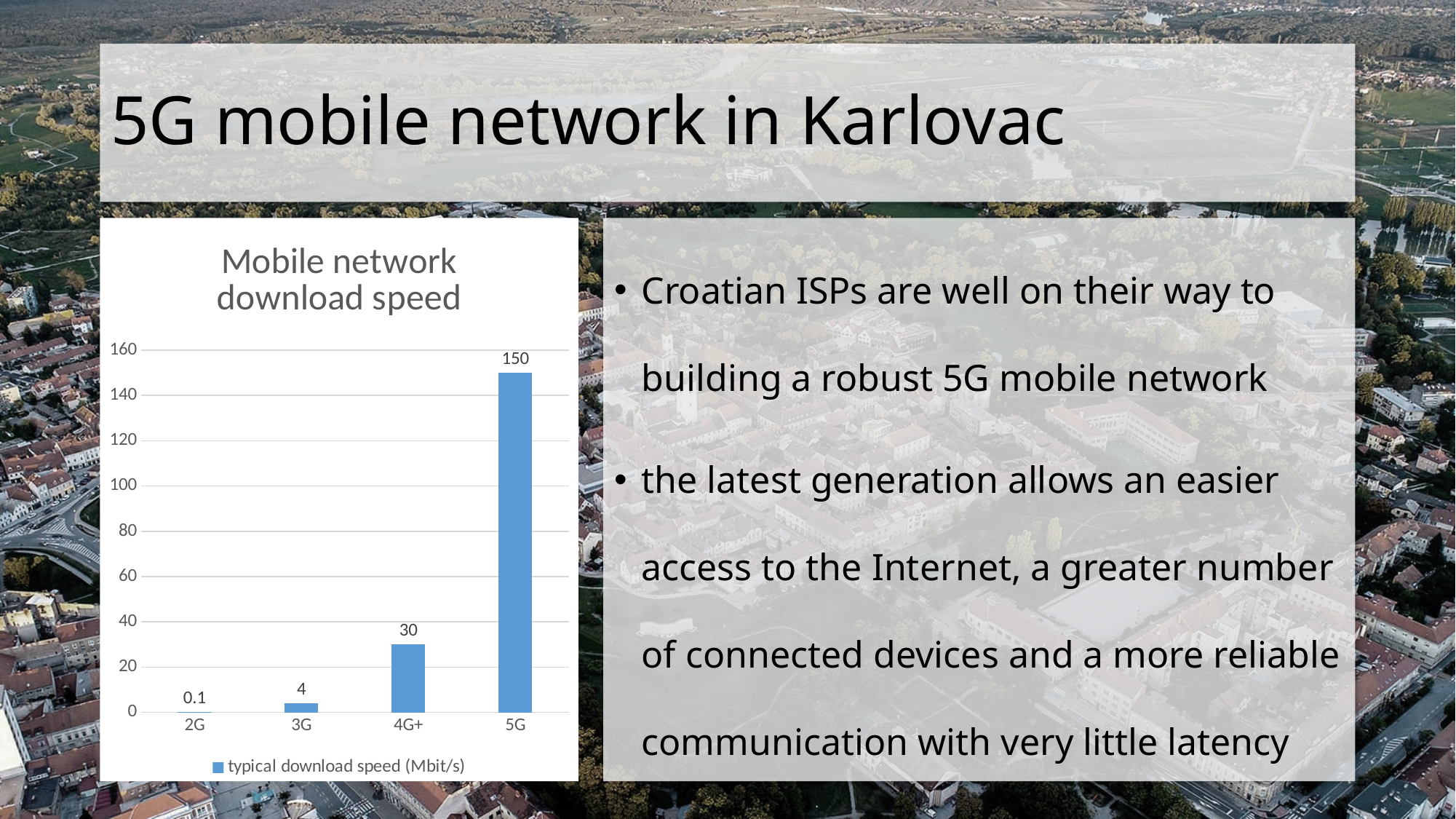
Which network generation has the highest typical download speed? 5G Which has a higher typical download speed, 3G or 4G+? 4G+ What is the typical download speed for 4G+? 30 What is the difference in typical download speed between 5G and 4G+? 120 How many network generations are shown on the chart? 4 Is the value for 5G greater or less than 140? greater What is the typical download speed for 5G? 150 What is the typical download speed for 3G? 4 What is the typical download speed for 2G? 0.1 What is the title of the chart? Mobile network download speed What kind of chart is shown on the slide? bar chart Which network generation has the lowest typical download speed? 2G